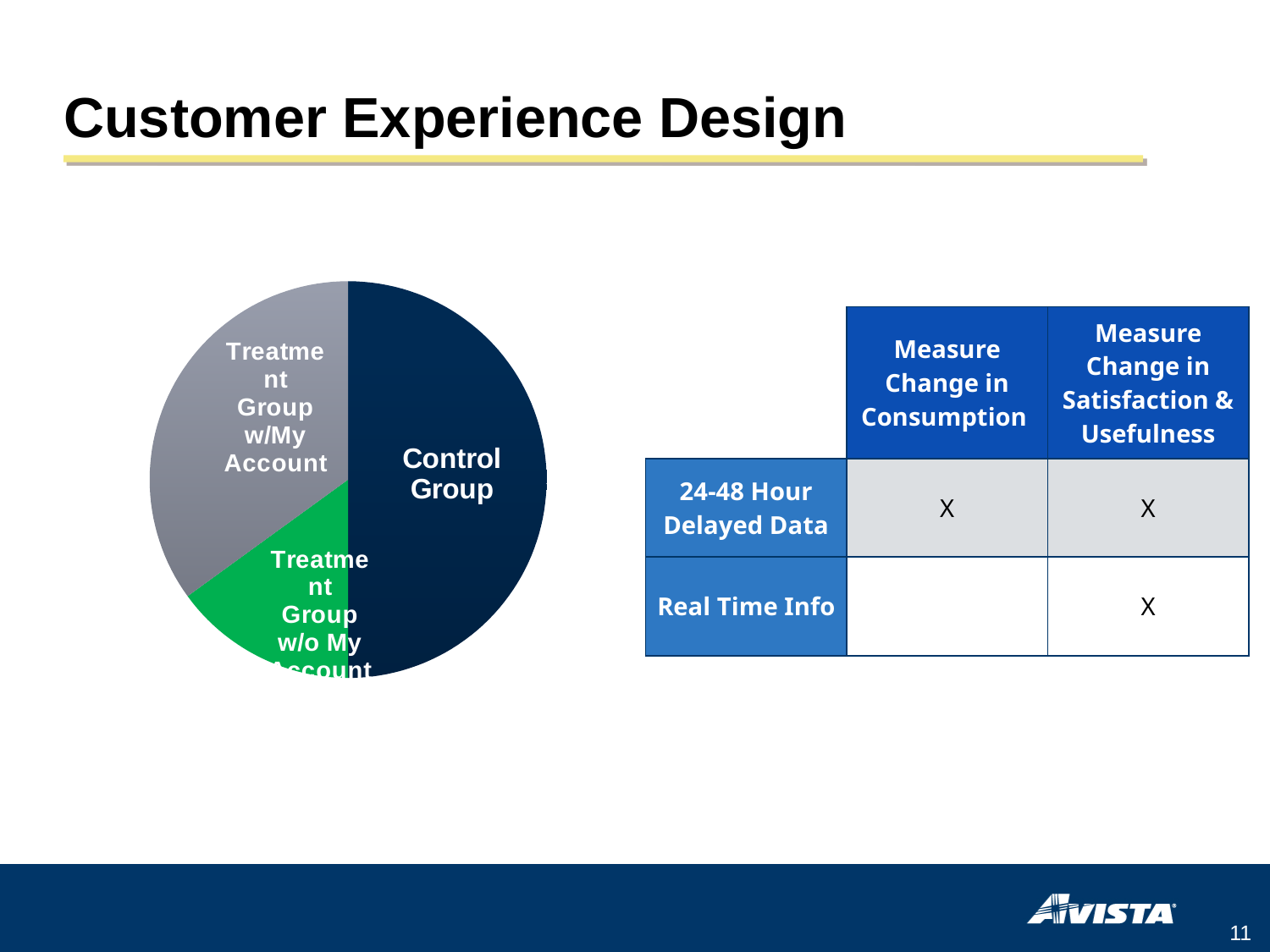
Which group has the smallest slice of the pie chart? Treatment Group w/o My Account How many slices does the pie chart have? 3 Which slice is larger: Control Group or Treatment Group w/o My Account? Control Group What kind of chart is shown on the slide? pie chart Which group is shown by the green slice of the pie chart? Treatment Group w/o My Account Which group has the largest slice of the pie chart? Control Group What colour is the Control Group slice in the pie chart? dark navy blue Which slice is larger: Treatment Group w/My Account or Treatment Group w/o My Account? Treatment Group w/My Account